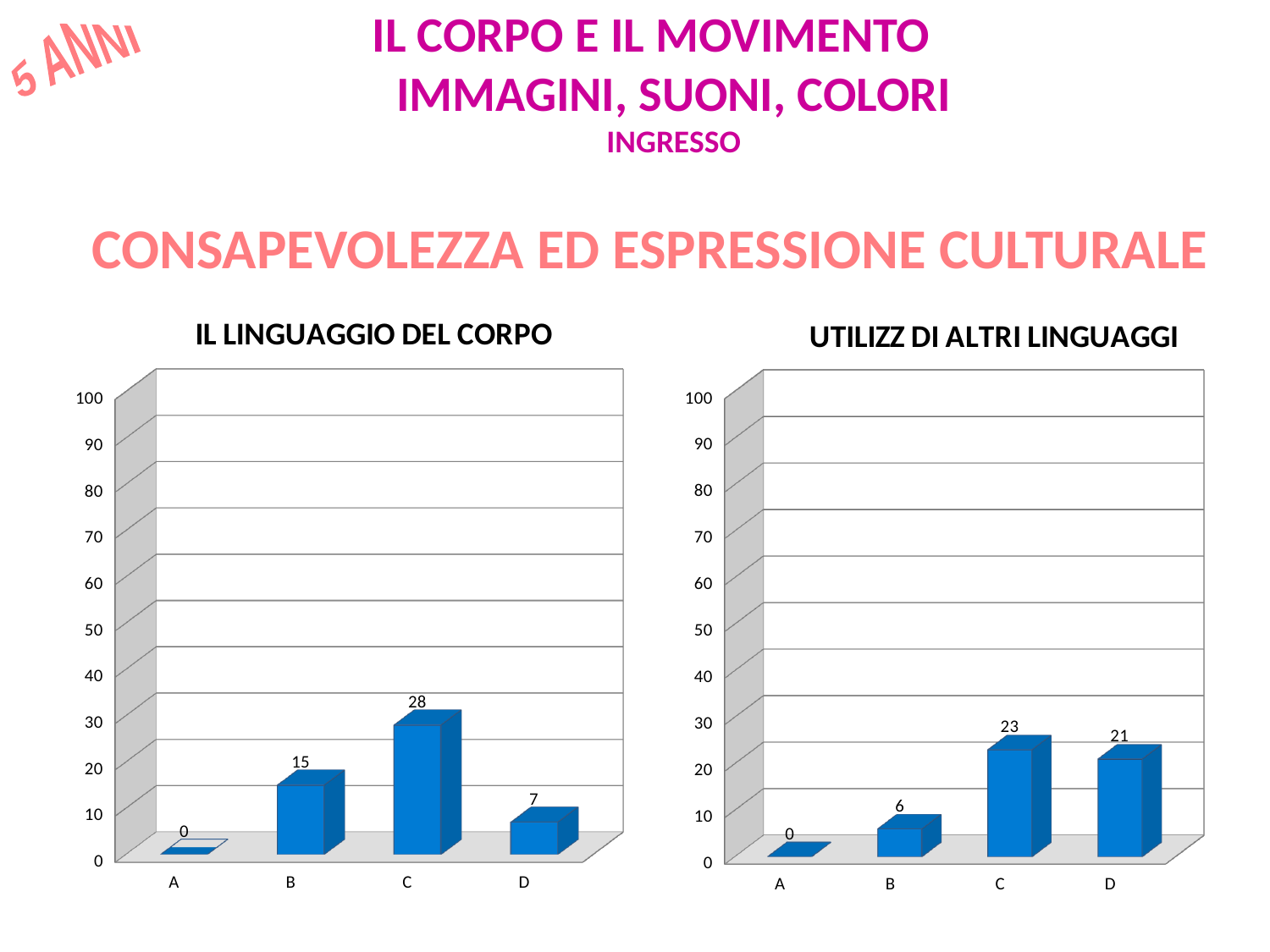
In the 'IL LINGUAGGIO DEL CORPO' chart, what is the value for category B? 15 In the 'UTILIZZ DI ALTRI LINGUAGGI' chart, which is larger, the value for C or the value for D? C In the 'UTILIZZ DI ALTRI LINGUAGGI' chart, which category has the lowest value? A In the 'IL LINGUAGGIO DEL CORPO' chart, what is the value for category C? 28 In the 'IL LINGUAGGIO DEL CORPO' chart, is the value for C greater or less than 20? greater In the 'IL LINGUAGGIO DEL CORPO' chart, what is the difference between the values for C and D? 21 What kind of chart is the 'UTILIZZ DI ALTRI LINGUAGGI' chart? bar chart In the 'IL LINGUAGGIO DEL CORPO' chart, which category has the highest value? C In the 'UTILIZZ DI ALTRI LINGUAGGI' chart, what is the value for category B? 6 In the 'UTILIZZ DI ALTRI LINGUAGGI' chart, what is the value for category D? 21 How many categories are shown on the x axis of the 'IL LINGUAGGIO DEL CORPO' chart? 4 In the 'UTILIZZ DI ALTRI LINGUAGGI' chart, what is the difference between the values for C and B? 17